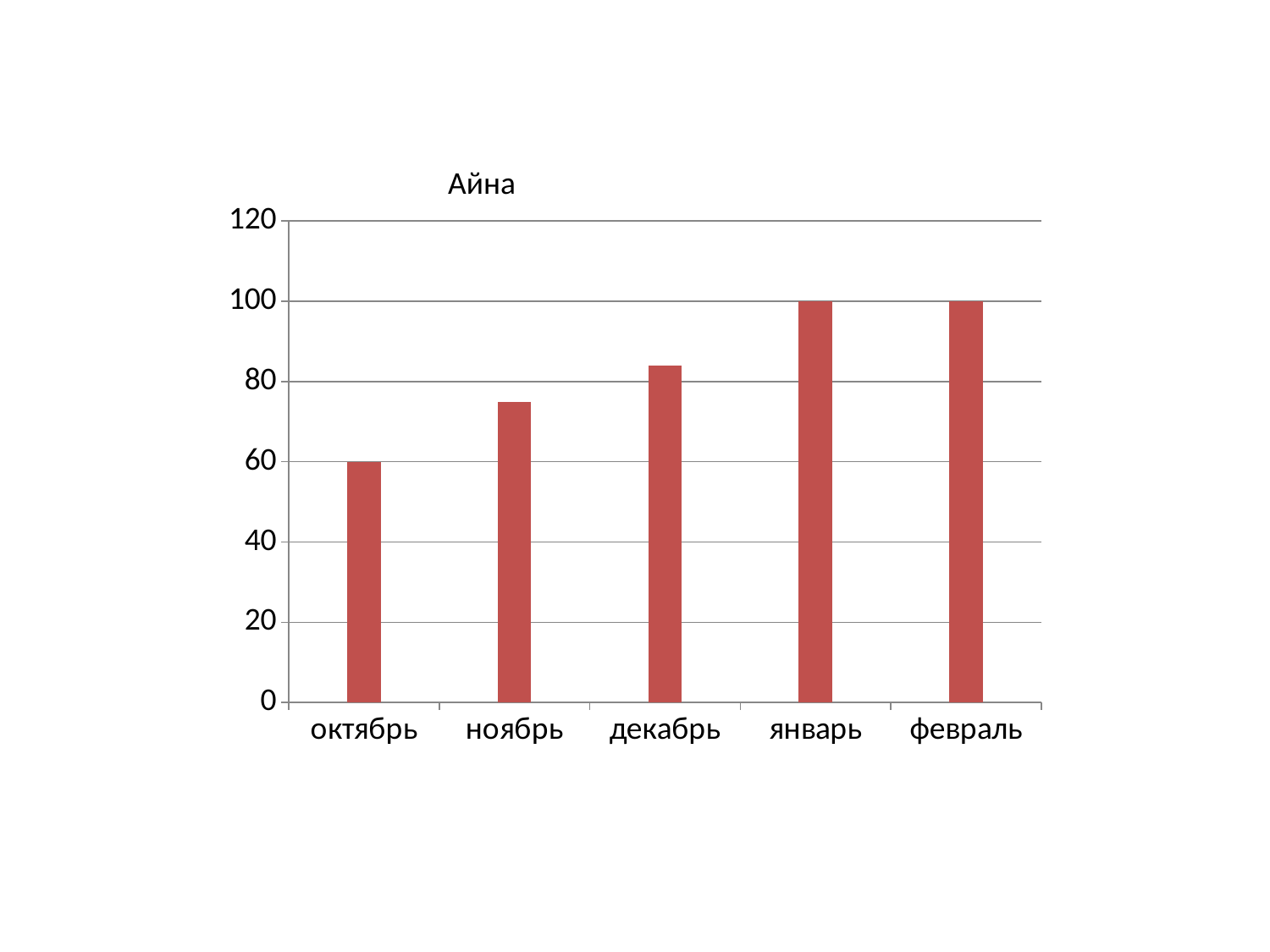
Which is larger, the value for декабрь or the value for ноябрь? декабрь Is the value for ноябрь greater or less than 80? less What is the value for февраль? 100 Is the value for декабрь greater or less than 80? greater Do the values rise or fall from октябрь to февраль? rise What kind of chart is shown on the slide? bar chart How many categories are shown on the x axis? 5 Which month has the lowest value? октябрь What is the difference between the value for январь and the value for октябрь? 40 What is the title of the chart? Айна What is the value for октябрь? 60 What is the value for январь? 100